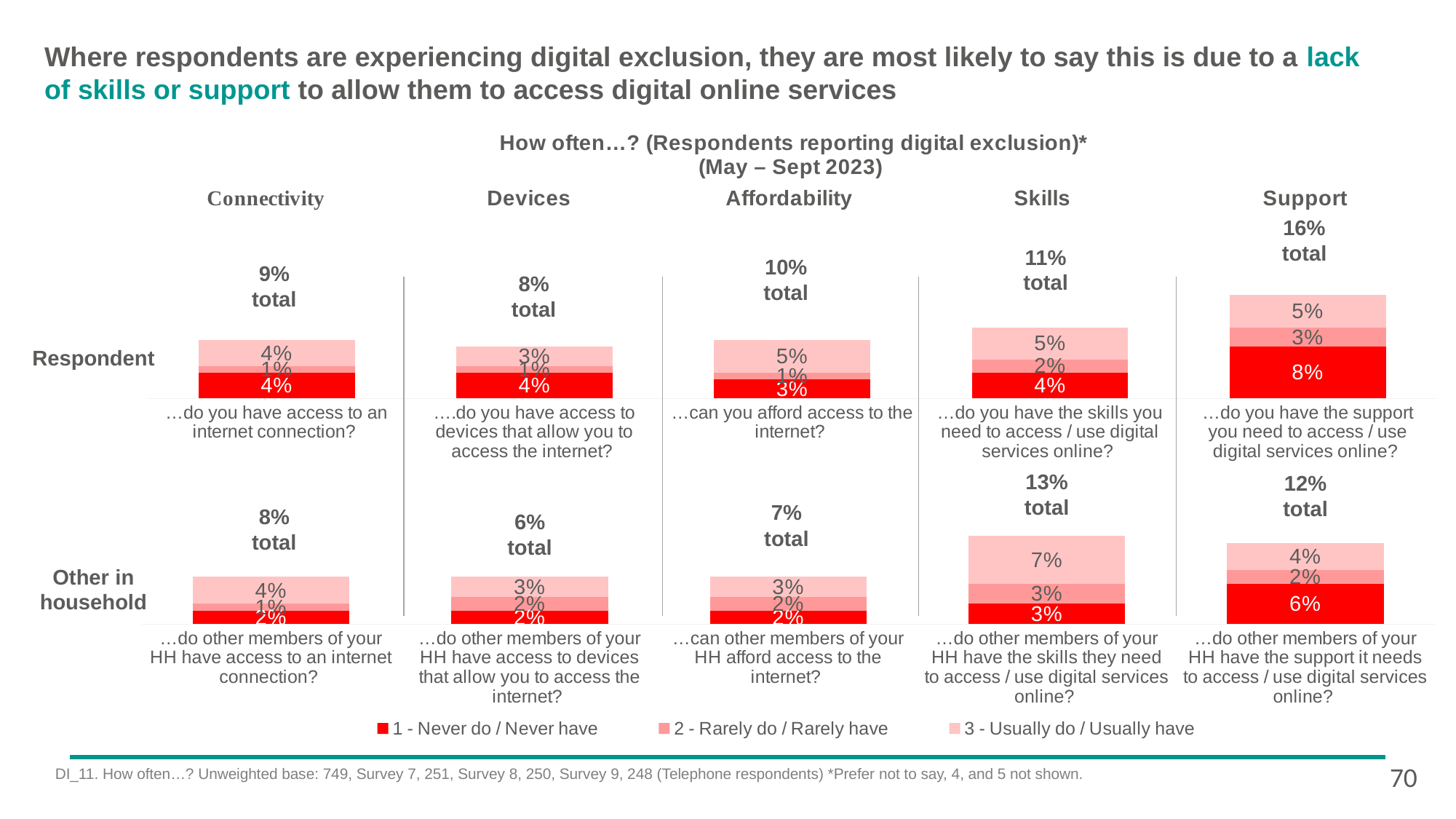
What colour represents '1 - Never do / Never have' in the legend? Red In the Other in household row, what is the 'Usually do / Usually have' value for Skills? 7% In the Respondent row, what percentage of respondents say they never have the support they need to access / use digital services online? 8% What kind of chart is used to show the Respondent Connectivity data? Stacked bar chart What is the total shown for Devices in the Other in household row? 6% total In the Respondent row, what is the 'Never do / Never have' value for Affordability? 3% How many series does the legend list? 3 In the Respondent row, which of the five areas has the highest total? Support In the Other in household row, which of the five areas has the lowest total? Devices What is the difference between the Respondent total for Support and the Respondent total for Connectivity? 7% Which is larger: the Other in household total for Skills or the Other in household total for Support? Skills In the Respondent row, what is the total shown for Support? 16% total